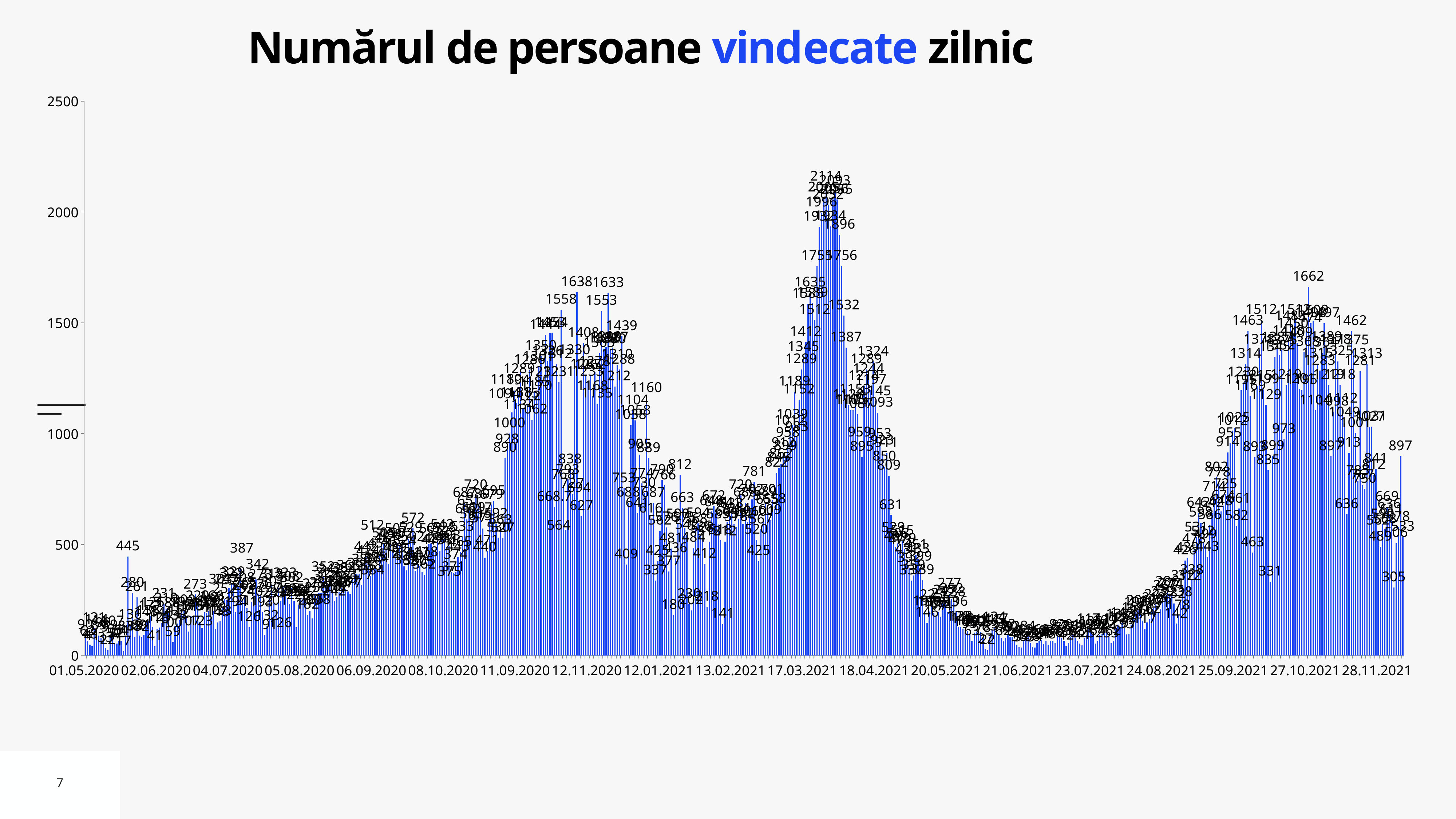
What is the highest data label value shown on the chart? 2114 What is the difference between the peak value 2114 and the peak value 1662? 452 Which is larger: the peak value near 17.03.2021 (2114) or the peak value near 27.10.2021 (1662)? 2114 (near 17.03.2021) How many date labels are shown on the x axis? 19 Is the value of the last bar on the chart greater or less than 1000? less What is the title of the chart? Numărul de persoane vindecate zilnic Is the highest bar near 17.03.2021 greater or less than 2000? greater What is the highest labelled value in the peak near 27.10.2021? 1662 What is the value labelled on the last (rightmost) bar of the chart? 533 What kind of chart is shown on the slide? bar chart What colour are the bars in the chart? blue